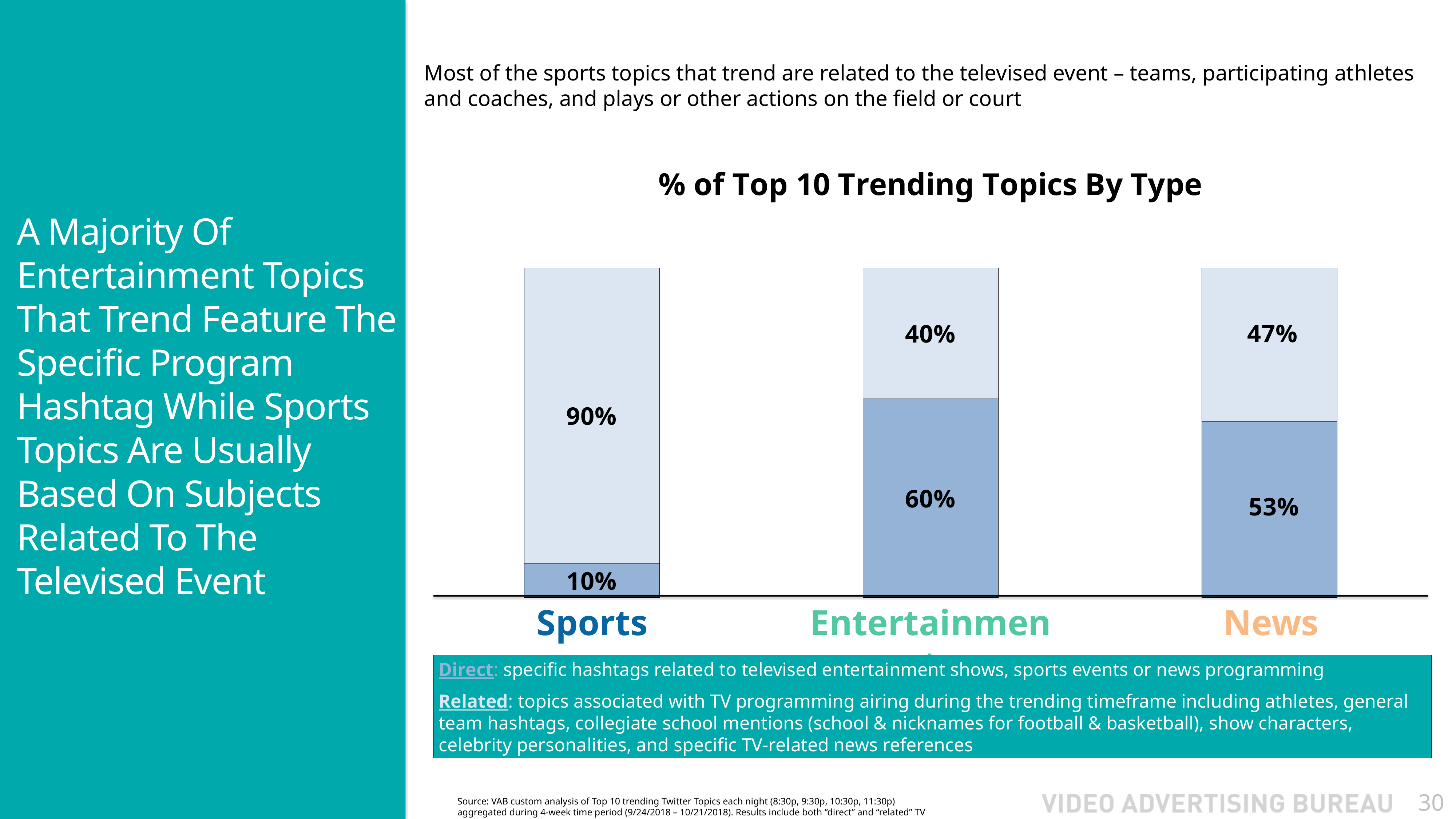
What is the difference between the top and bottom segments of the Sports bar? 80% What is the value of the bottom (darker blue) segment of the Entertainment bar? 60% How many categories are shown along the x axis of the chart? 3 What kind of chart is shown under the title "% of Top 10 Trending Topics By Type"? bar chart What is the value of the top (lighter blue) segment of the Sports bar? 90% Which category has the smallest bottom (darker blue) segment? Sports What is the value of the top (lighter blue) segment of the News bar? 47% In the News bar, which segment is larger, the bottom (darker blue) or the top (lighter blue)? bottom (darker blue) What is the value of the bottom (darker blue) segment of the Sports bar? 10% What is the title of the chart? % of Top 10 Trending Topics By Type What is the total of the two segments in the Entertainment bar? 100% Which category has the largest bottom (darker blue) segment? Entertainment